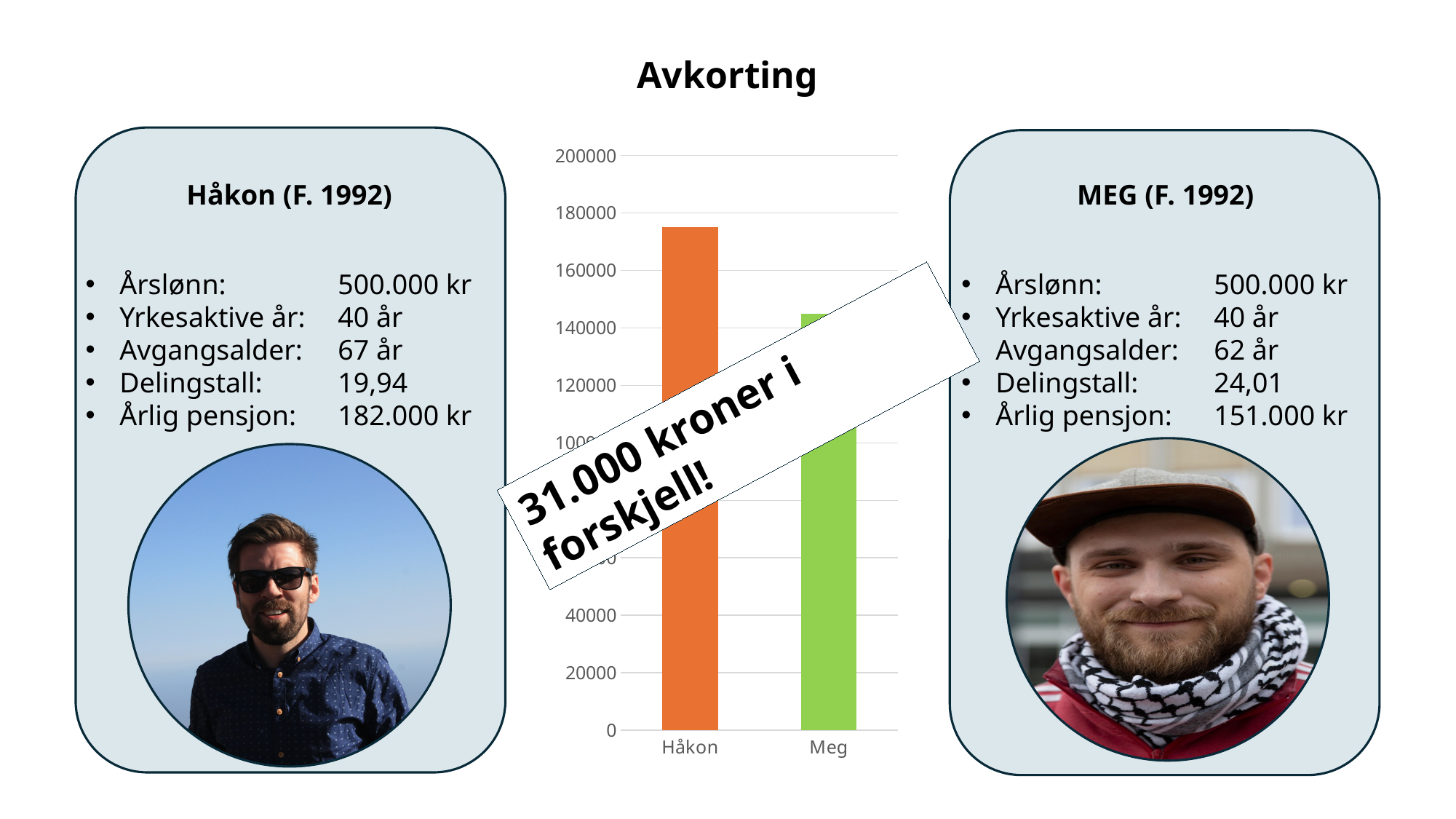
What colour is the bar for Meg in the chart? green Do the bar values rise or fall from Håkon to Meg along the x axis? fall What kind of chart is shown on the slide? bar chart What is the title of the chart? Avkorting Which bar is taller, Håkon or Meg? Håkon Is the value for Meg greater or less than 120000? greater Which category has the lowest bar in the chart? Meg How many categories are plotted on the x axis of the chart? 2 Is the value for Meg greater or less than 160000? less Is the value for Håkon greater or less than 200000? less Which category has the highest bar in the chart? Håkon